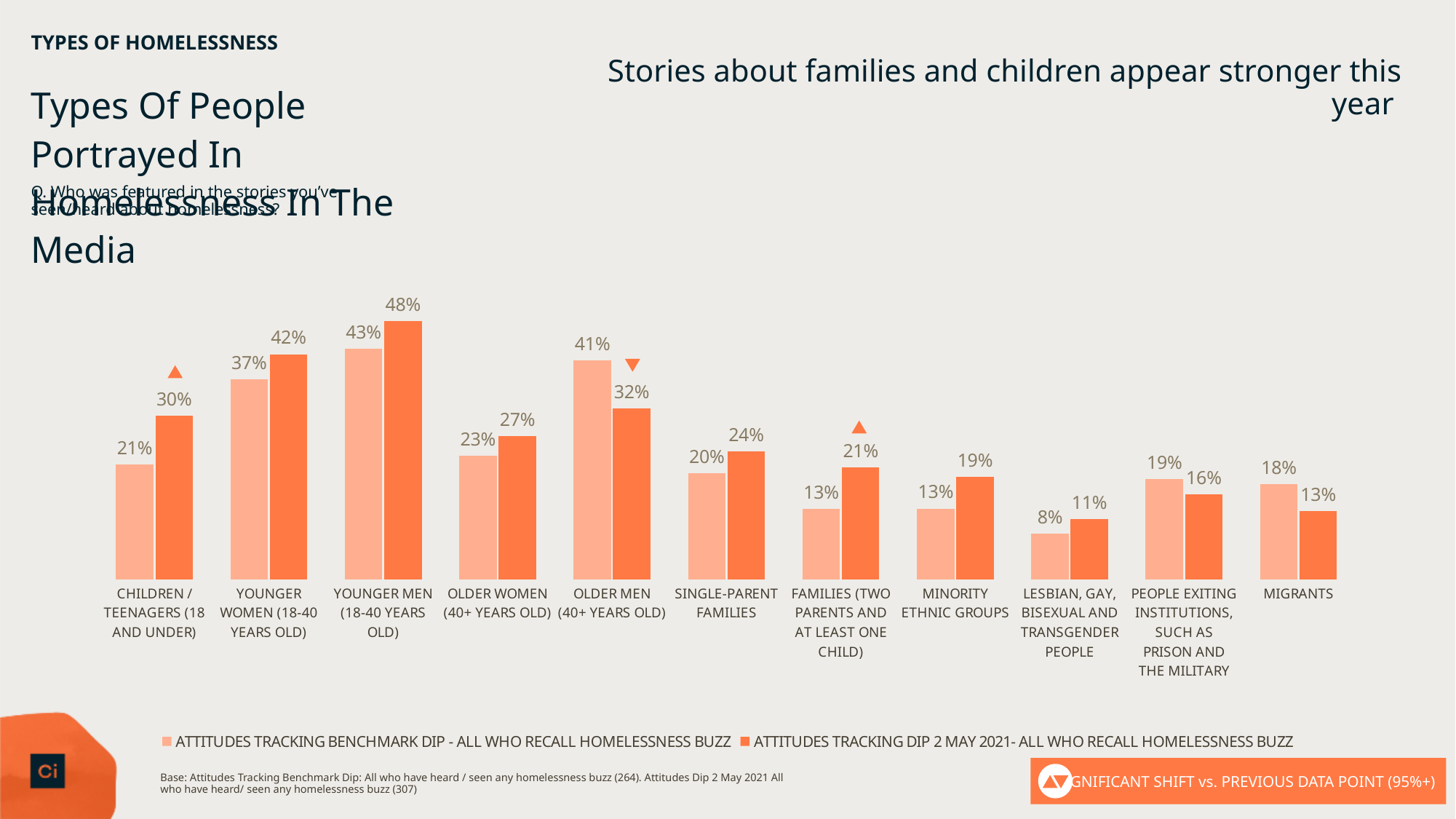
Which category has the lowest value in the Attitudes Tracking Benchmark Dip series? Lesbian, Gay, Bisexual and Transgender People What is the value for Migrants in the Attitudes Tracking Dip 2 May 2021 series? 13% For Families (two parents and at least one child), which series has the larger value? Attitudes Tracking Dip 2 May 2021 For People Exiting Institutions, such as prison and the military, which series has the larger value? Attitudes Tracking Benchmark Dip What is the difference between the two series for Children / Teenagers (18 and under)? 9% What is the value for Older Men (40+ years old) in the Attitudes Tracking Benchmark Dip series? 41% What kind of chart is shown on the slide? Bar chart What is the value for Younger Men (18-40 years old) in the Attitudes Tracking Dip 2 May 2021 series? 48% How many series does the legend list? 2 What is the difference between the Benchmark Dip and Dip 2 May 2021 values for Older Men (40+ years old)? 9% How many categories are shown on the x axis of the chart? 11 Which category has the highest value in the Attitudes Tracking Dip 2 May 2021 series? Younger Men (18-40 years old)